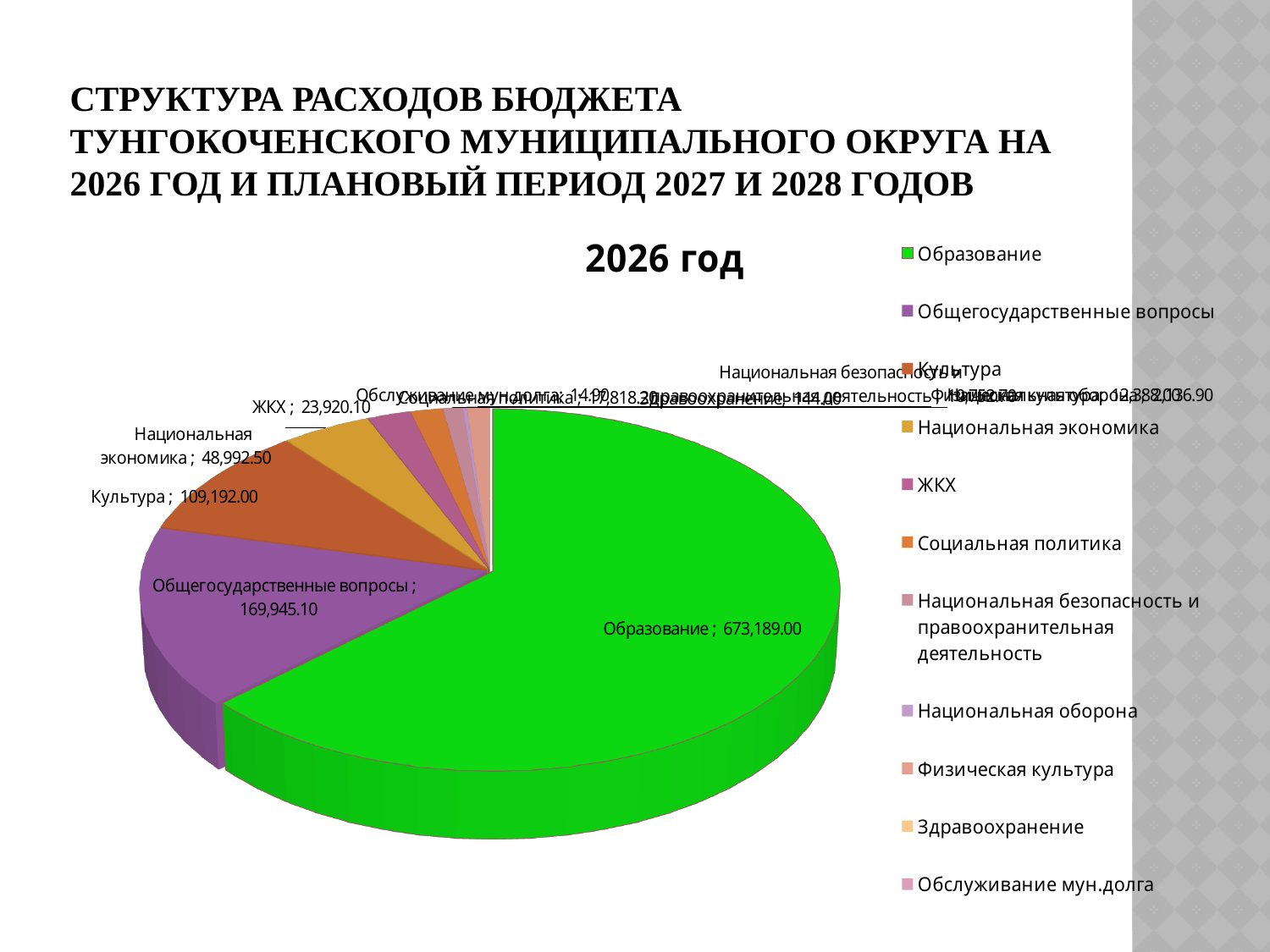
What is the value for ЖКХ? 23,920.10 How many entries does the legend list? 11 What is the difference between the values for Национальная экономика and ЖКХ? 25,072.40 What is the difference between the values for Образование and Общегосударственные вопросы? 503,243.90 What is the value for Образование? 673,189.00 What is the value for Национальная экономика? 48,992.50 What is the value for Общегосударственные вопросы? 169,945.10 Which category has the largest slice of the pie? Образование What kind of chart is shown on the slide? Pie chart What is the value for Культура? 109,192.00 Which is larger, Культура or Национальная экономика? Культура What is the title of the chart? 2026 год